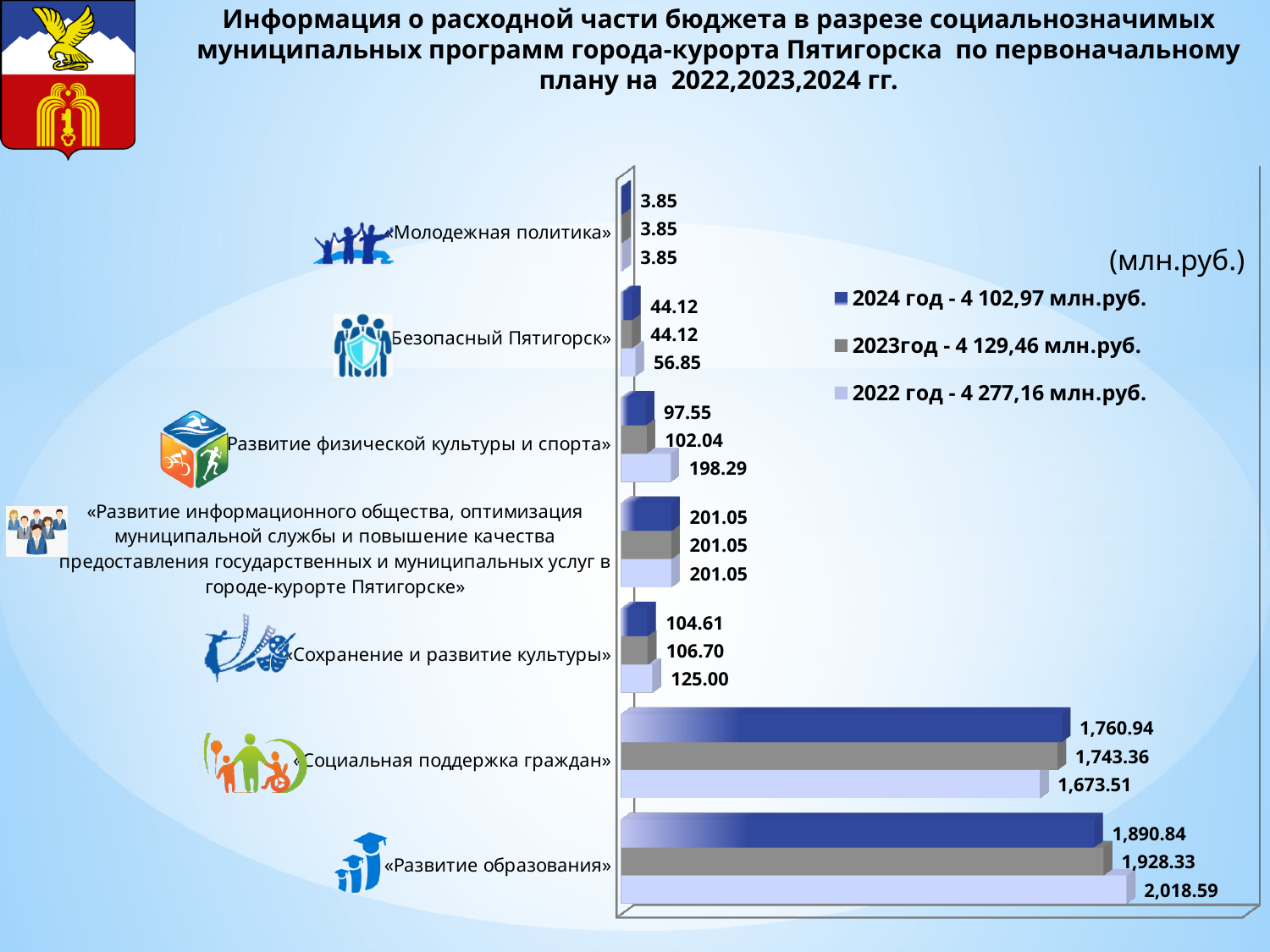
What kind of chart is shown on the slide? bar chart How many series does the legend list? 3 What is the value for «Развитие физической культуры и спорта» in the 2023 series? 102.04 What is the value for «Безопасный Пятигорск» in the 2022 series? 56.85 Which program has the lowest value in the 2022 series? «Молодежная политика» According to the legend, what is the total for the 2023 series? 4 129,46 млн.руб. Which program has the highest value in the 2024 series? «Развитие образования» What is the difference between the 2022 and 2024 values for «Развитие образования»? 127.75 What is the value for «Развитие образования» in the 2022 series? 2,018.59 For «Социальная поддержка граждан», which is larger: the 2024 value or the 2022 value? 2024 value How many municipal programs (categories) are shown in the chart? 7 What is the value for «Социальная поддержка граждан» in the 2024 series? 1,760.94